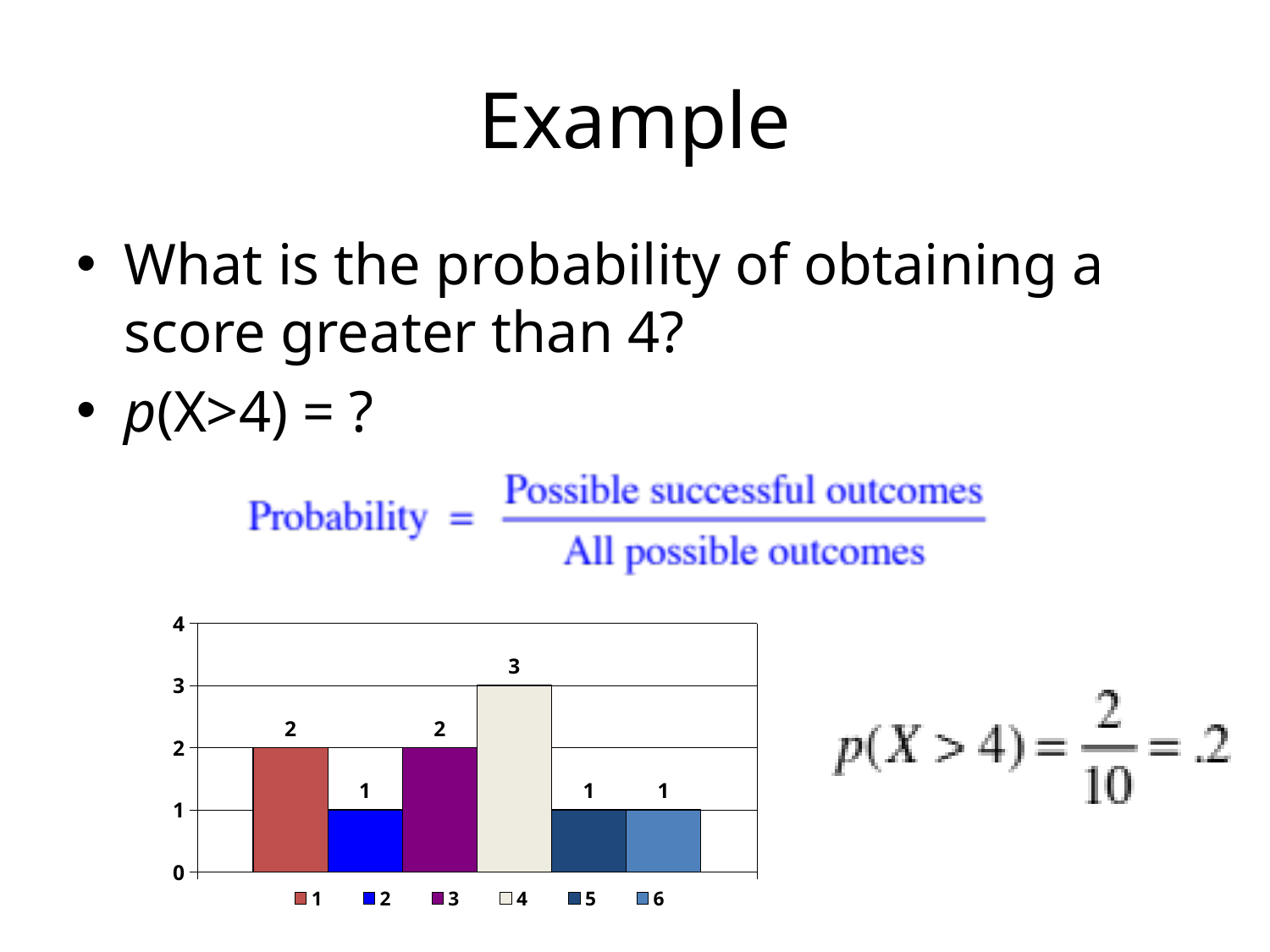
How many entries does the legend list? 6 Is the value for score 4 greater or less than 2? greater Which score has the highest bar? 4 Which is larger, the bar for score 3 or the bar for score 6? 3 What is the highest value shown on the vertical axis? 4 What is the difference between the bar for score 4 and the bar for score 2? 2 What is the value of the bar for score 5? 1 How many bars are plotted in the chart? 6 What is the value of the bar for score 1? 2 What is the value of the bar for score 4? 3 What kind of chart is shown on the slide? bar chart What is the total of the bars for scores 5 and 6? 2